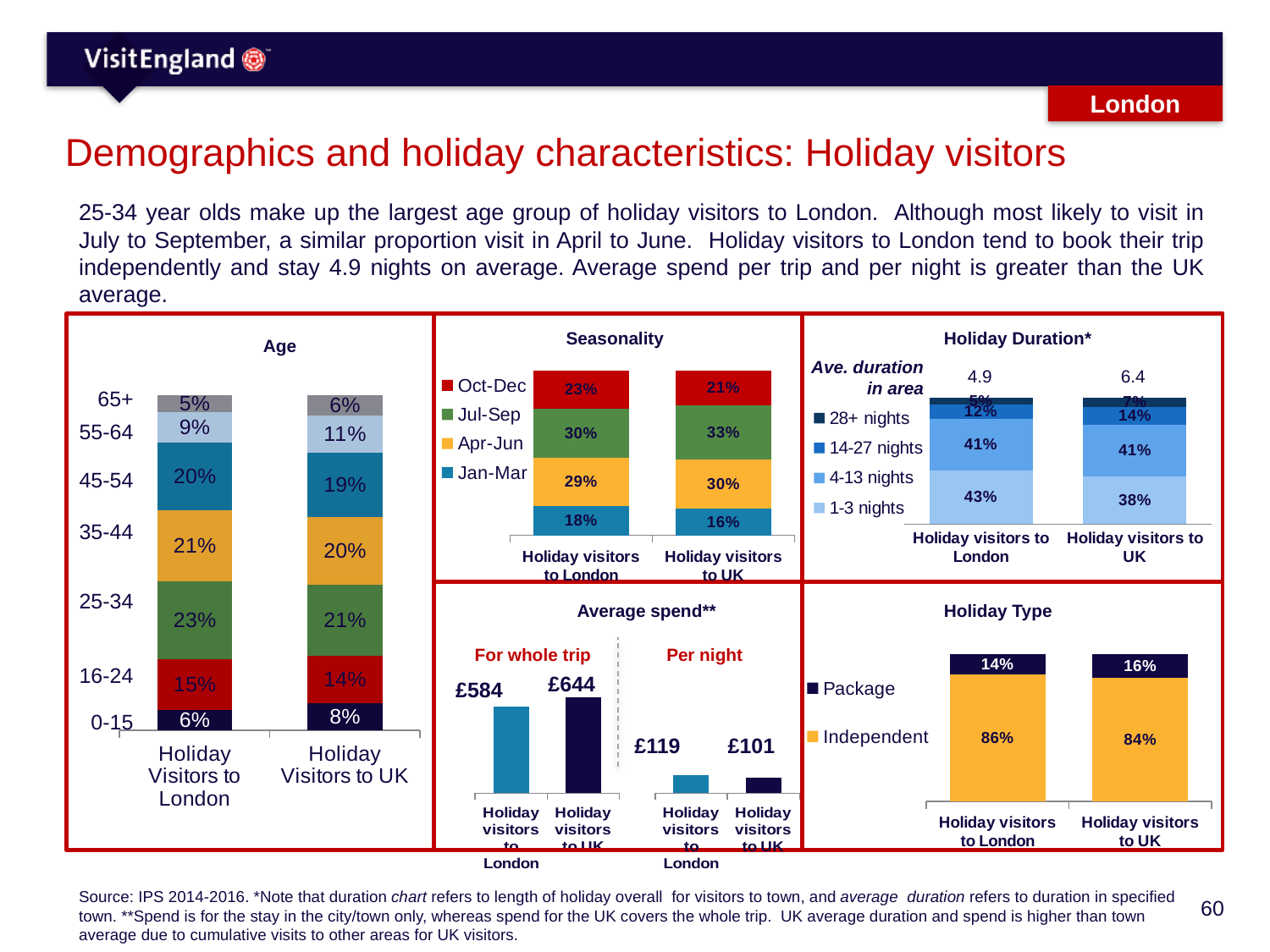
How many series does the legend of the Seasonality chart list? 4 In the Age chart, what percentage of holiday visitors to London are aged 25-34? 23% In the Seasonality chart, which quarter has the smallest share of holiday visitors to UK? Jan-Mar In the Average spend chart, what is the spend for the whole trip for holiday visitors to UK? £644 In the Holiday Type chart, what percentage of holiday visitors to London book independently? 86% In the Average spend chart, what is the difference between the per night spend for holiday visitors to London and for holiday visitors to UK? £18 In the Age chart, what is the difference between the 0-15 share for holiday visitors to UK and for holiday visitors to London? 2% In the Average spend chart, which is larger: the per night spend for holiday visitors to London or for holiday visitors to UK? Holiday visitors to London In the Age chart, which age group is the largest for holiday visitors to London? 25-34 In the Seasonality chart, what percentage of holiday visitors to London visit in Jul-Sep? 30% In the Holiday Duration chart, what percentage of holiday visitors to UK stay 1-3 nights? 38% In the Holiday Duration chart, what is the average duration in area for holiday visitors to London? 4.9